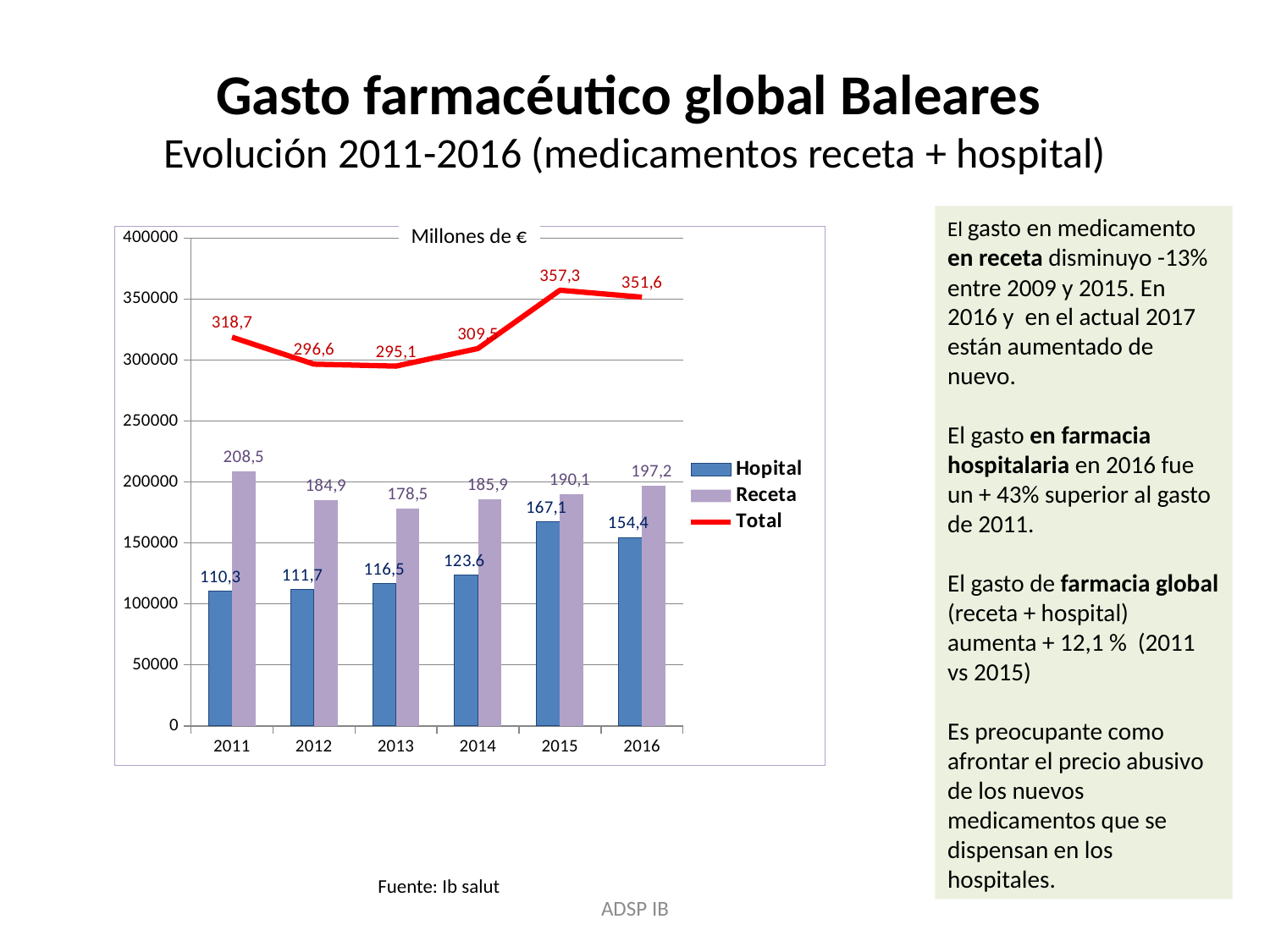
Which is larger in 2016, the Hopital value or the Receta value? Receta What is the value of the Hopital series for 2014? 123.6 In which year is the Total line at its highest? 2015 What is the value of the Hopital series for 2011? 110,3 How many years are shown on the x axis? 6 What is the value of the Receta series for 2016? 197,2 What is the difference between the Receta values for 2011 and 2012? 23,6 What is the value of the Total line for 2015? 357,3 In which year is the Receta series at its lowest? 2013 What is the difference between the Hopital values for 2015 and 2011? 56,8 How many series does the legend list? 3 In which year is the Hopital series at its highest? 2015